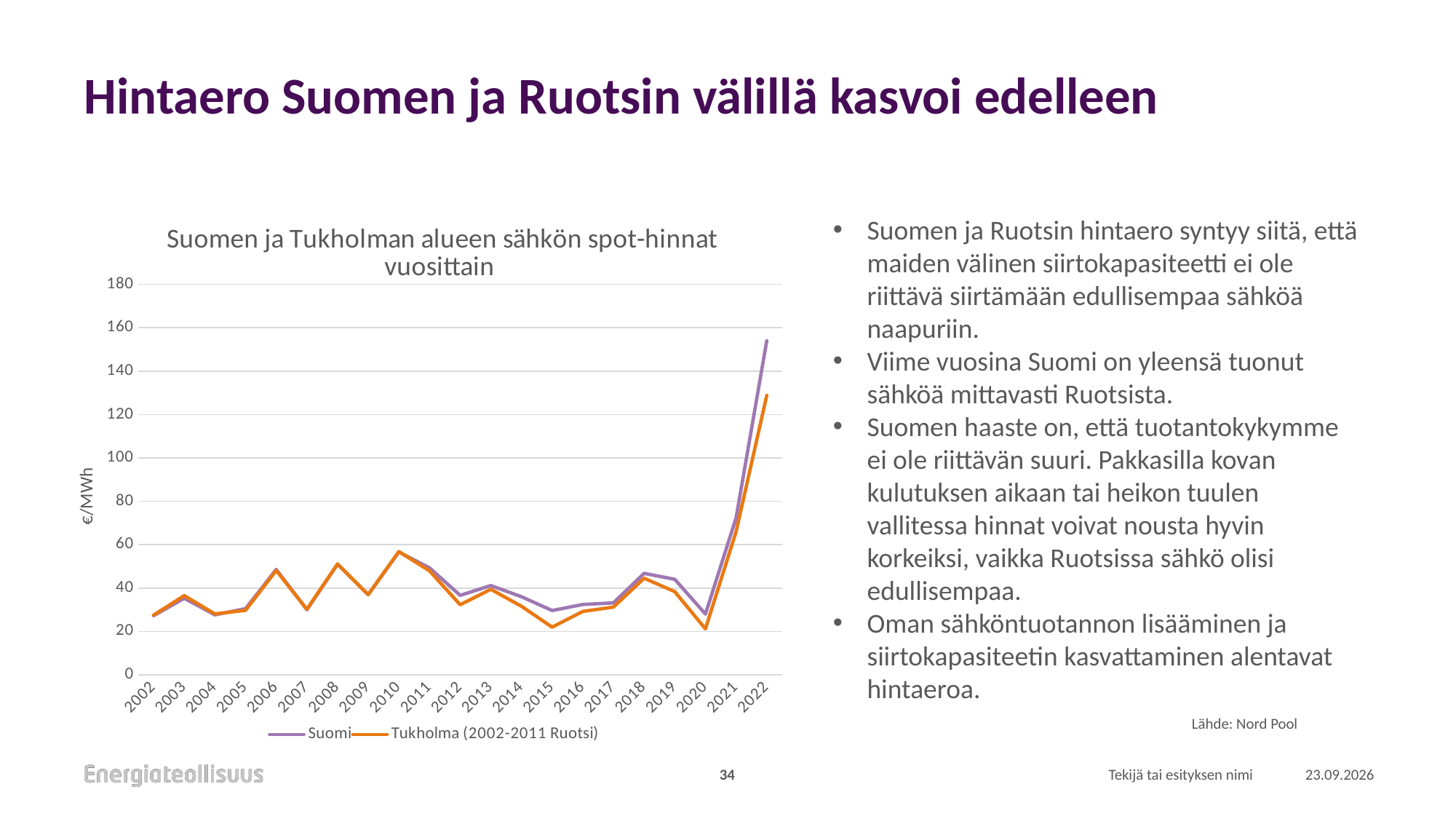
Is the value for Tukholma (2002-2011 Ruotsi) in 2022 greater or less than 120? greater In which year does the Tukholma (2002-2011 Ruotsi) series reach its lowest value? 2020 What kind of chart is shown on the slide? line chart Is the value for Tukholma (2002-2011 Ruotsi) in 2020 greater or less than 40? less Do the values rise or fall from 2020 to 2022? rise In 2022, which series has the higher value, Suomi or Tukholma (2002-2011 Ruotsi)? Suomi In which year does the Suomi series reach its highest value? 2022 Is the value for Suomi in 2018 greater or less than 40? greater How many series does the legend list? 2 What unit is shown on the y axis label? €/MWh How many years are plotted along the x axis? 21